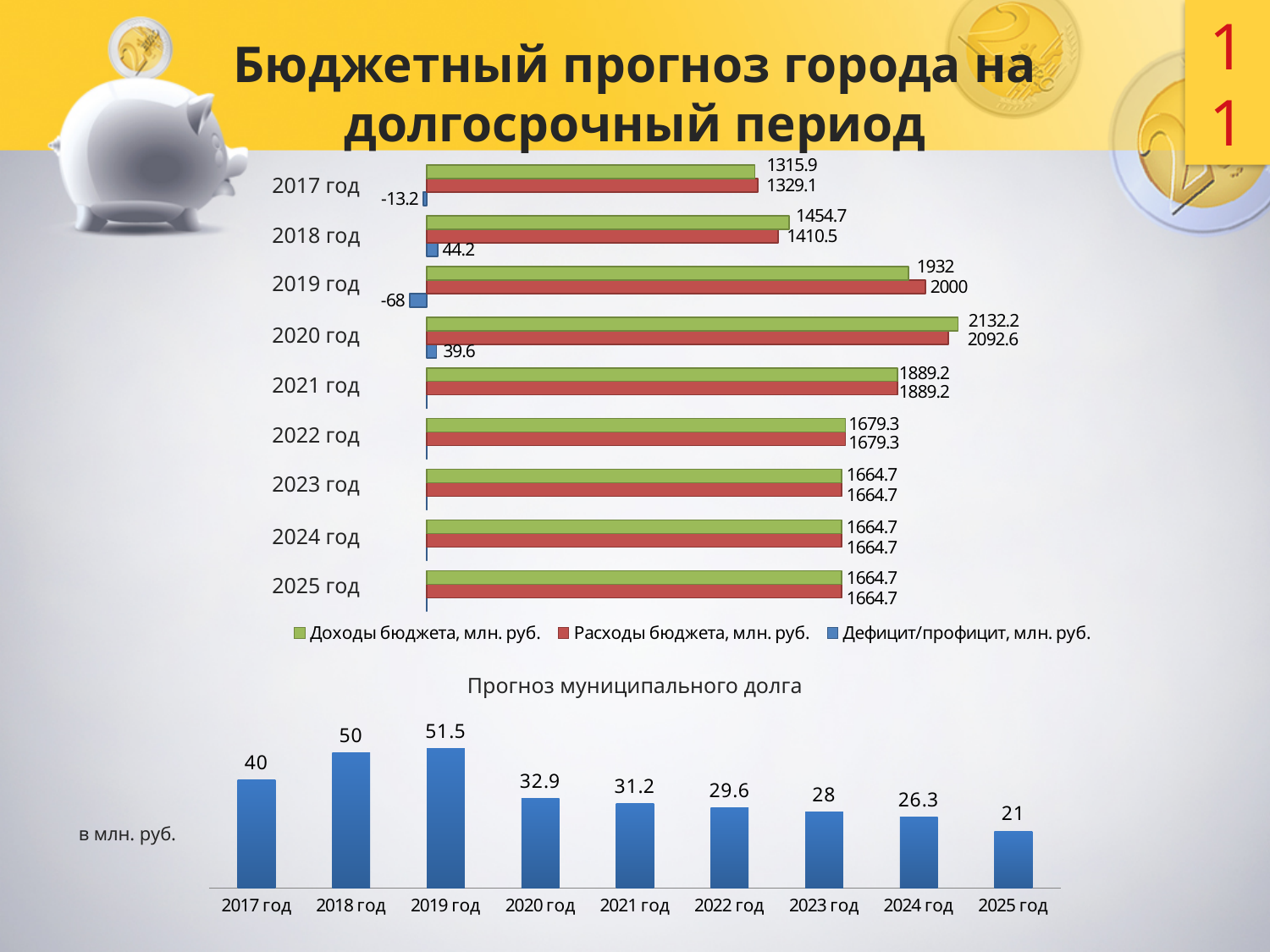
In the top chart, what is the difference between Расходы бюджета and Доходы бюджета for 2017 год? 13.2 In the top chart, what is the value of Расходы бюджета for 2019 год? 2000 In the chart titled Прогноз муниципального долга, what is the value for 2020 год? 32.9 In the chart titled Прогноз муниципального долга, what is the difference between the values for 2019 год and 2025 год? 30.5 In the top chart, what is the Дефицит/профицит value for 2018 год? 44.2 In the top chart, which is larger for 2018 год: Доходы бюджета or Расходы бюджета? Доходы бюджета In the top chart, which year has the highest Доходы бюджета? 2020 год In the chart titled Прогноз муниципального долга, which year has the lowest value? 2025 год What kind of chart is the one titled Прогноз муниципального долга? Bar chart In the top chart, how many series does the legend list? 3 In the top chart, what is the value of Доходы бюджета for 2020 год? 2132.2 In the chart titled Прогноз муниципального долга, which year has the highest value? 2019 год